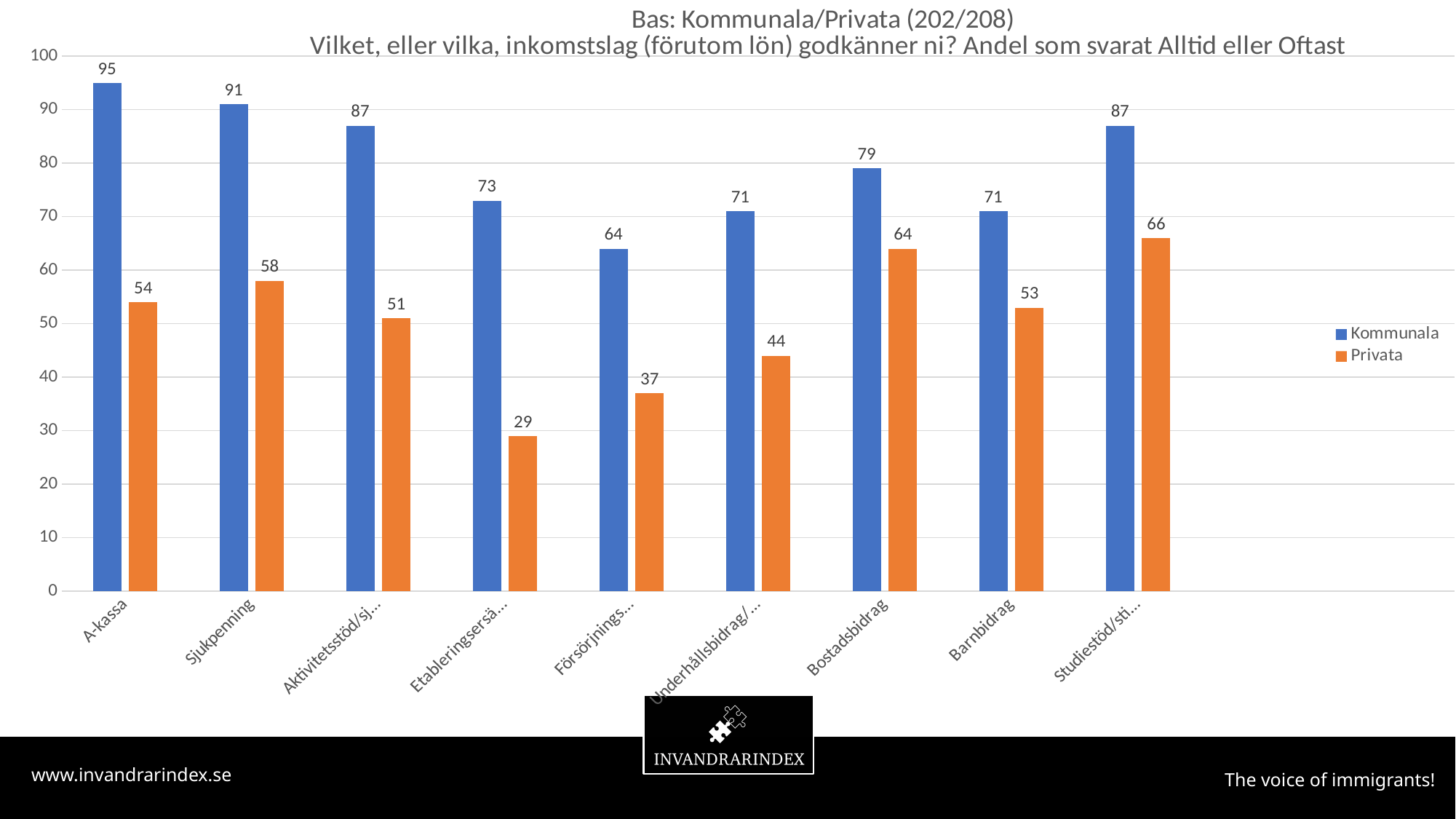
What is the Kommunala value for Bostadsbidrag? 79 What is the Privata value for Barnbidrag? 53 What kind of chart is shown on the slide? bar chart How many categories are shown on the x axis? 9 What is the Kommunala value for A-kassa? 95 Which is larger: the Kommunala value for Sjukpenning or the Kommunala value for Barnbidrag? Sjukpenning Which category has the highest Kommunala value? A-kassa Is the Privata value for Bostadsbidrag greater or less than 60? greater What is the difference between the Kommunala and Privata values for Bostadsbidrag? 15 What is the Privata value for Sjukpenning? 58 What is the difference between the Kommunala and Privata values for A-kassa? 41 How many series does the legend list? 2